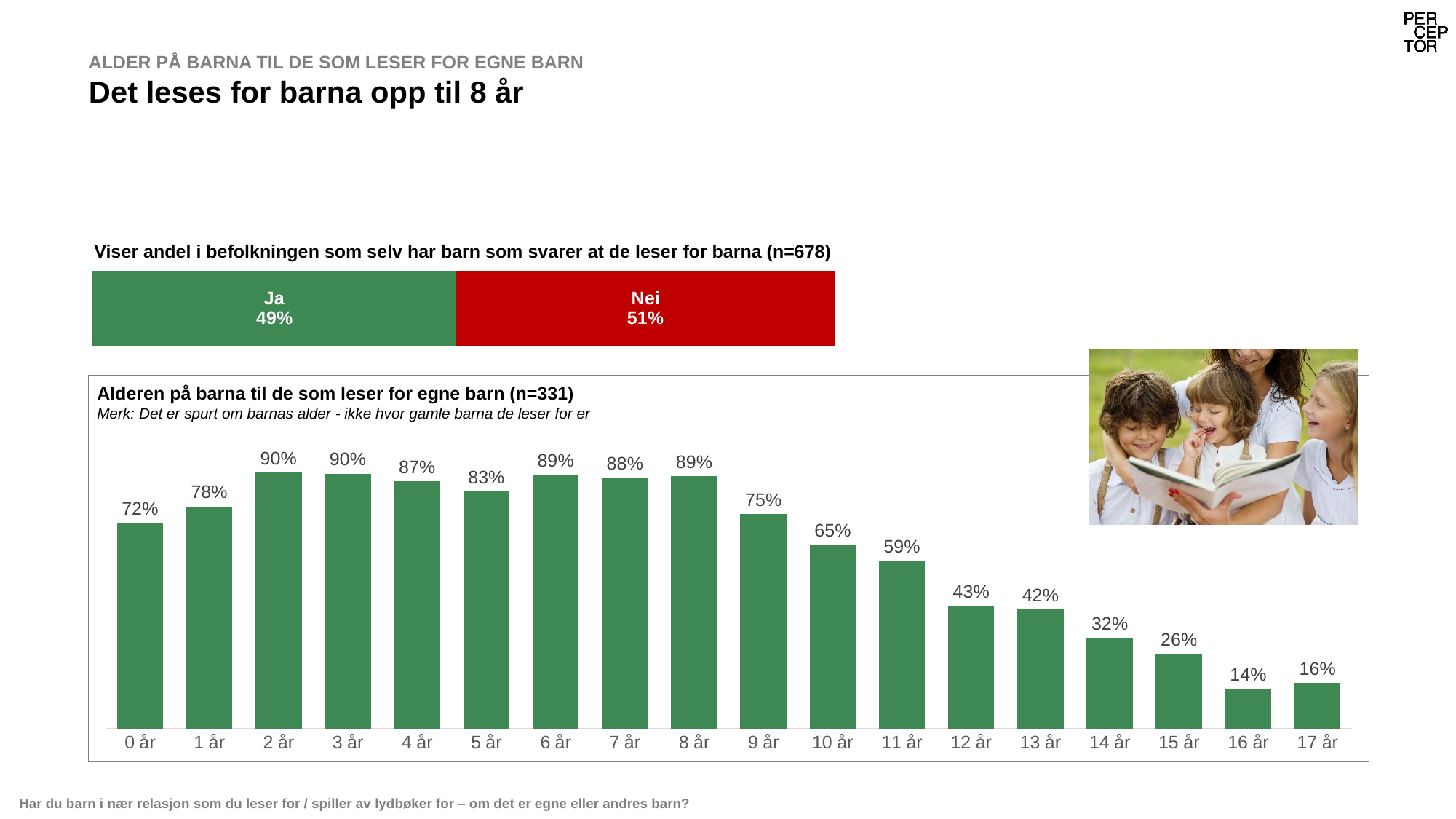
In the chart 'Viser andel i befolkningen som selv har barn som svarer at de leser for barna (n=678)', what colour is the Ja segment? Green In the chart 'Alderen på barna til de som leser for egne barn (n=331)', which age category has the lowest value? 16 år In the chart 'Alderen på barna til de som leser for egne barn (n=331)', do the values generally rise or fall from 8 år to 16 år? Fall In the chart 'Viser andel i befolkningen som selv har barn som svarer at de leser for barna (n=678)', which is larger, Ja or Nei? Nei In the chart 'Alderen på barna til de som leser for egne barn (n=331)', how many age categories are shown? 18 In the chart 'Alderen på barna til de som leser for egne barn (n=331)', which is larger, the value for 12 år or the value for 15 år? 12 år In the chart 'Alderen på barna til de som leser for egne barn (n=331)', what is the value for 0 år? 72% In the chart 'Viser andel i befolkningen som selv har barn som svarer at de leser for barna (n=678)', what is the value for Nei? 51% In the chart 'Alderen på barna til de som leser for egne barn (n=331)', what is the value for 14 år? 32% In the chart 'Alderen på barna til de som leser for egne barn (n=331)', what is the difference between the values for 8 år and 9 år? 14 percentage points In the chart 'Alderen på barna til de som leser for egne barn (n=331)', what is the value for 9 år? 75% What kind of chart is 'Alderen på barna til de som leser for egne barn (n=331)'? Bar chart